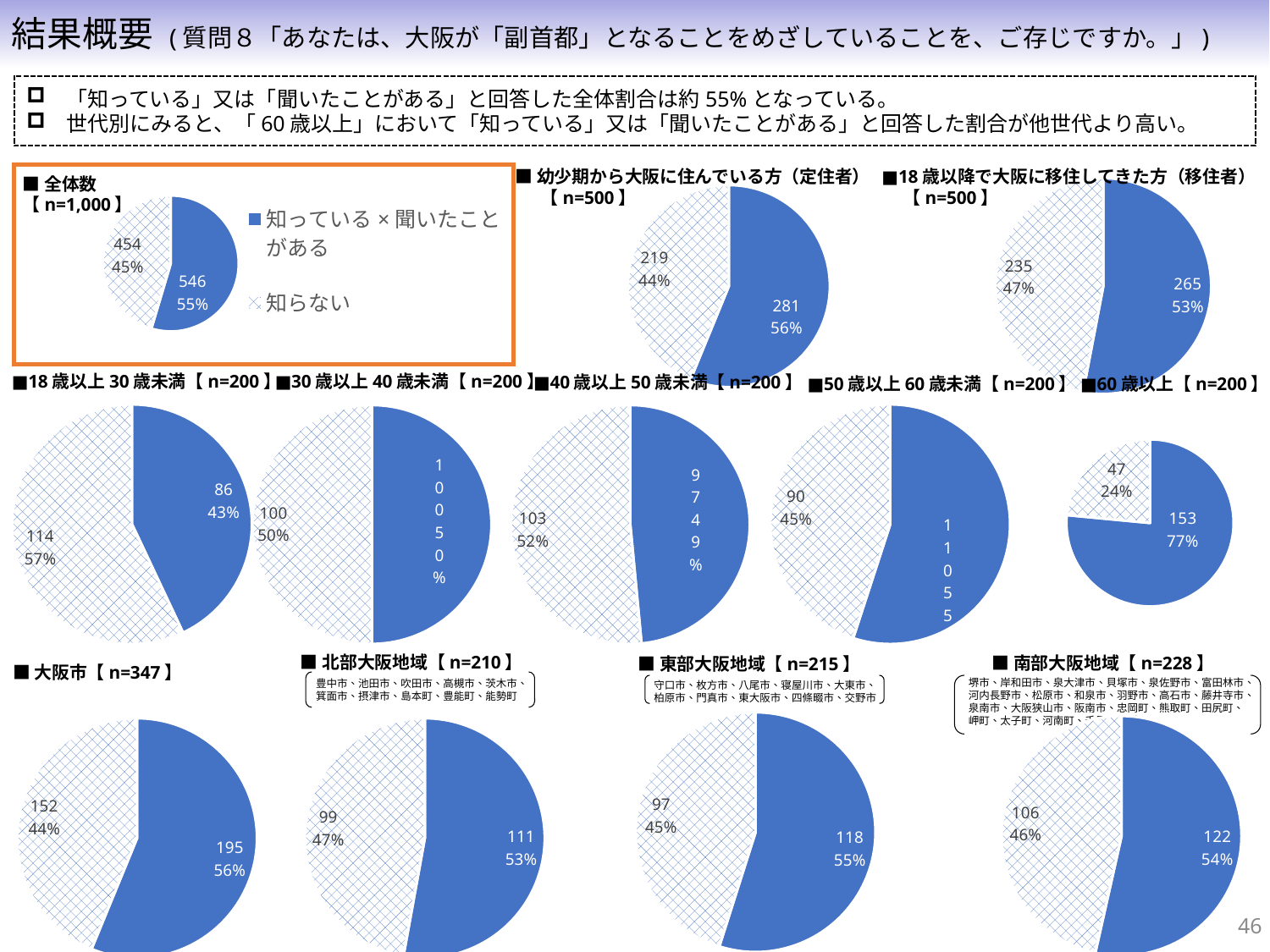
「60歳以上【n=200】」のグラフで、「知っている×聞いたことがある」の割合は何%ですか。 77% 「南部大阪地域【n=228】」のグラフで、「知らない」の割合は何%ですか。 46% 「大阪市【n=347】」のグラフで、「知っている×聞いたことがある」の値はいくつですか。 195 「50歳以上60歳未満【n=200】」のグラフで、「知っている×聞いたことがある」と「知らない」のどちらの値が大きいですか。 知っている×聞いたことがある 「全体数【n=1,000】」のグラフの凡例には、いくつの項目がありますか。 2 「全体数【n=1,000】」のグラフで、「知っている×聞いたことがある」の値はいくつですか。 546 「東部大阪地域【n=215】」のグラフで、「知っている×聞いたことがある」の値はいくつですか。 118 「全体数【n=1,000】」のグラフは、どの種類のグラフですか。 円グラフ 「幼少期から大阪に住んでいる方（定住者）【n=500】」のグラフで、「知っている×聞いたことがある」の割合は何%ですか。 56% 「18歳以上30歳未満【n=200】」のグラフで、「知っている×聞いたことがある」と「知らない」の値の差はいくつですか。 28 「18歳以降で大阪に移住してきた方（移住者）【n=500】」のグラフで、「知らない」の値はいくつですか。 235